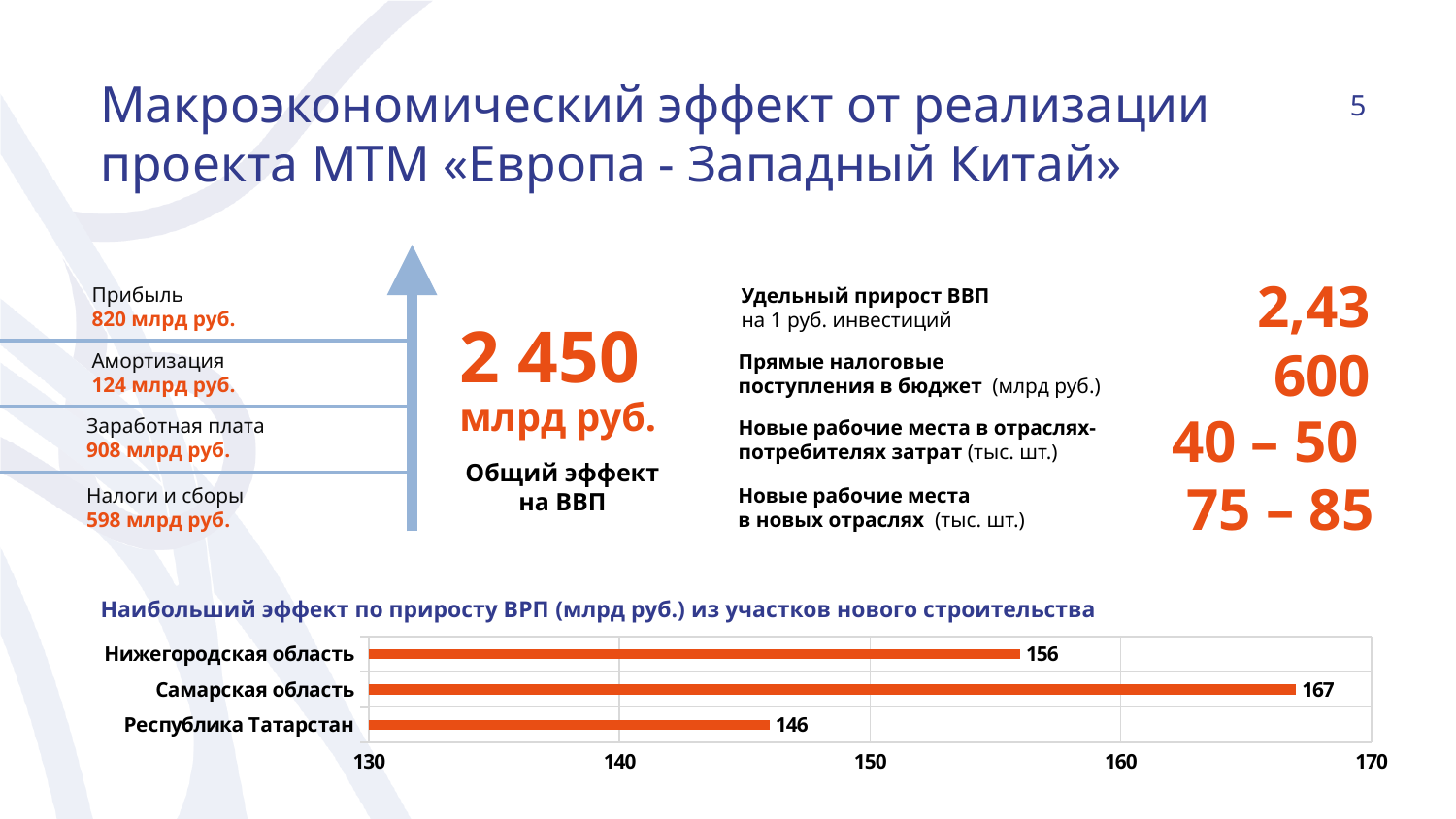
Which region has the highest value in the bar chart? Самарская область What is the value for Нижегородская область in the bar chart? 156 Which region has the lowest value in the bar chart? Республика Татарстан What is the value for Республика Татарстан in the bar chart? 146 What is the value for Самарская область in the bar chart? 167 How many regions are shown in the bar chart? 3 What is the title of the bar chart? Наибольший эффект по приросту ВРП (млрд руб.) из участков нового строительства What kind of chart is shown at the bottom of the slide? bar chart What is the difference between the values for Самарская область and Нижегородская область? 11 Is the value for Республика Татарстан greater or less than 150? less What is the difference between the values for Самарская область and Республика Татарстан? 21 Which is larger: the value for Нижегородская область or the value for Республика Татарстан? Нижегородская область